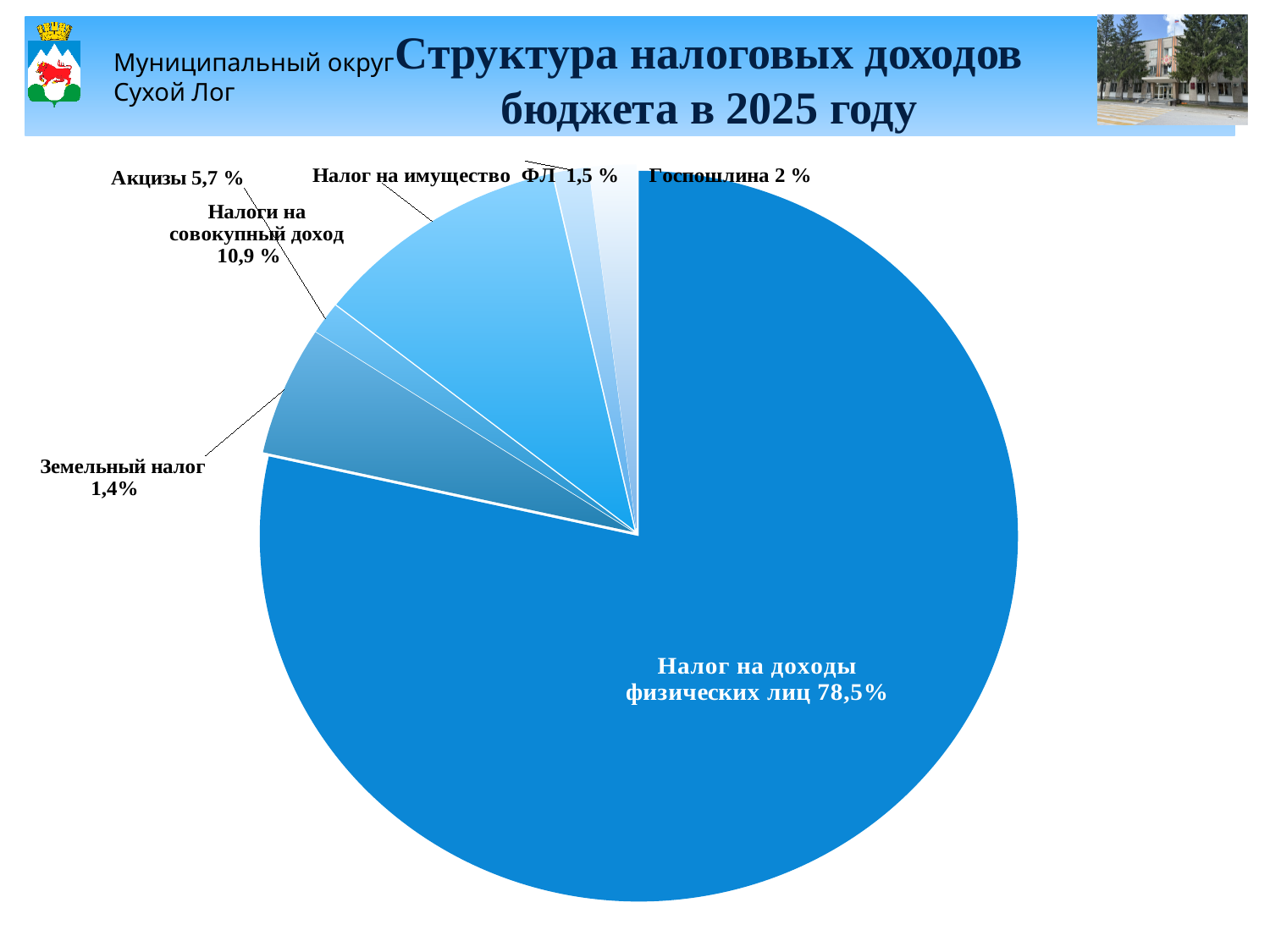
What is the value shown for Акцизы? 5,7 % What share of tax revenues does Налог на доходы физических лиц account for? 78,5% What is the value shown for Налоги на совокупный доход? 10,9 % What is the title of the chart? Структура налоговых доходов бюджета в 2025 году What is the difference in percentage points between Налоги на совокупный доход and Акцизы? 5,2 Which category has the smallest share of the pie? Земельный налог What is the value shown for Земельный налог? 1,4% What is the value shown for Госпошлина? 2 % Which category has the largest share of the pie? Налог на доходы физических лиц What is the value shown for Налог на имущество ФЛ? 1,5 % What kind of chart is shown on the slide? pie chart How many slices does the pie chart have? 6